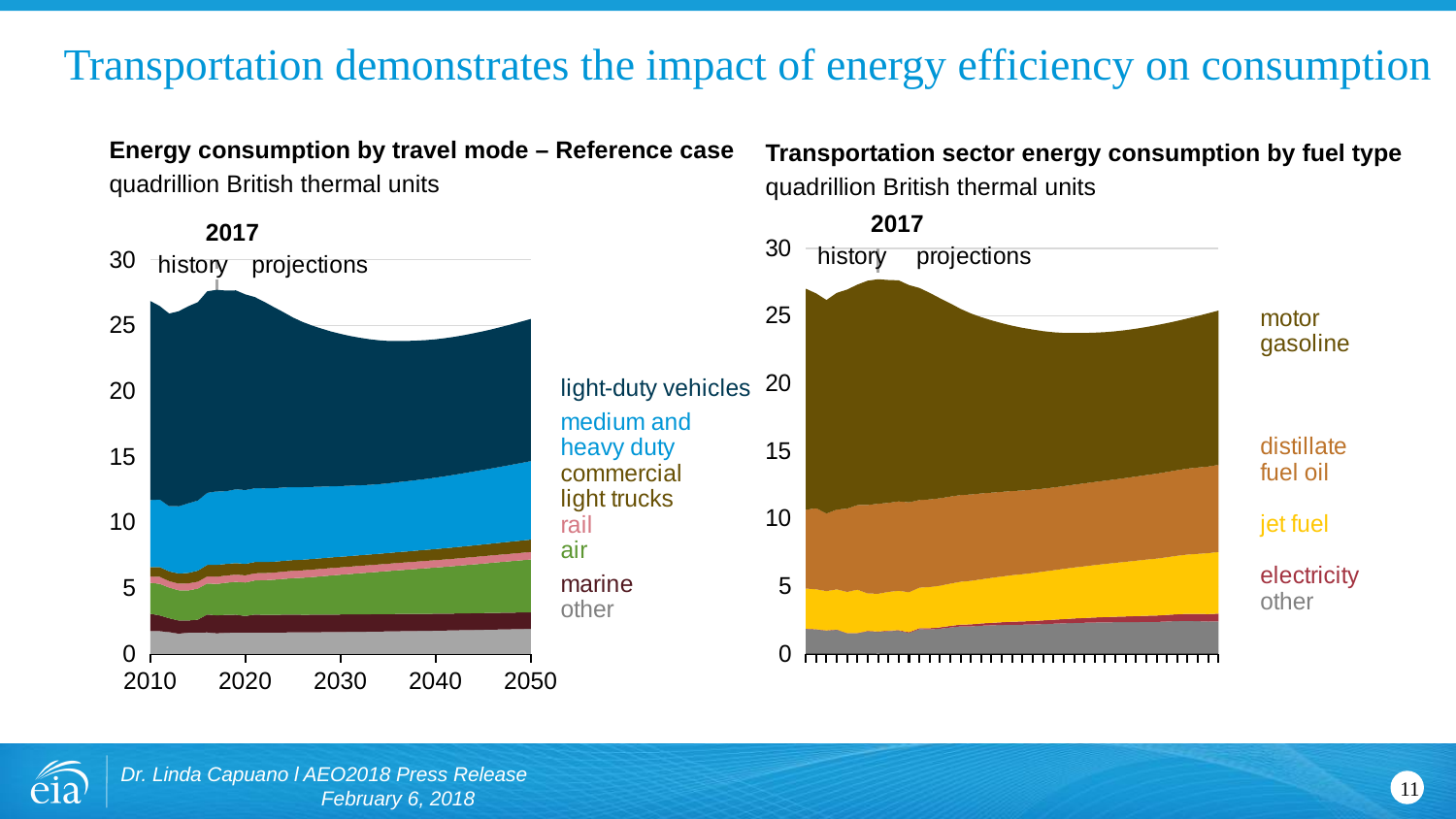
In the left chart, 'Energy consumption by travel mode – Reference case', which travel mode accounts for the largest share of consumption? light-duty vehicles What kind of chart is the right chart, 'Transportation sector energy consumption by fuel type'? stacked area chart In the right chart, 'Transportation sector energy consumption by fuel type', which fuel type accounts for the largest share of consumption? motor gasoline In the right chart, 'Transportation sector energy consumption by fuel type', is the total energy consumption around 2035 greater or less than 25? less How many series does the legend of the right chart, 'Transportation sector energy consumption by fuel type', list? 5 In the left chart, 'Energy consumption by travel mode – Reference case', is the total energy consumption in 2010 greater or less than 25? greater Which year marks the boundary between history and projections on both charts? 2017 What kind of chart is the left chart, 'Energy consumption by travel mode – Reference case'? stacked area chart What unit of measurement is used on both charts? quadrillion British thermal units How many series does the legend of the left chart, 'Energy consumption by travel mode – Reference case', list? 7 In the right chart, 'Transportation sector energy consumption by fuel type', does total consumption rise or fall between 2017 and 2030? fall